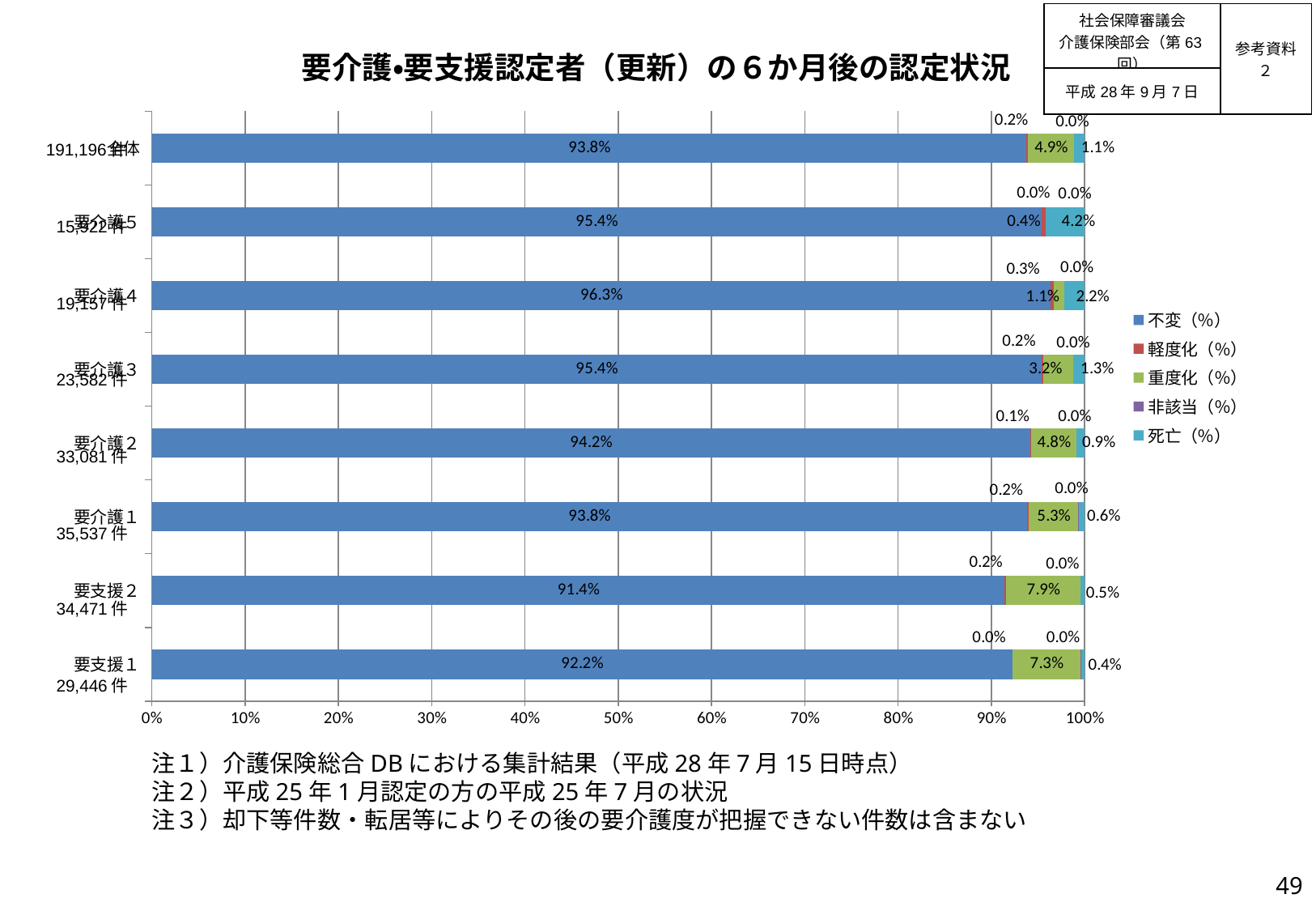
What kind of chart is shown on the slide? Stacked bar chart Which category has the highest 重度化（%） value? 要支援2 How many categories are shown on the chart? 8 Which category has the lowest 不変（%） value? 要支援2 How many series does the legend list? 5 Which category has the highest 不変（%） value? 要介護4 What is the difference between the 重度化（%） values for 要支援2 and 要支援1? 0.6% What is the 死亡（%） value for 要介護5? 4.2% What is the 軽度化（%） value for 要介護4? 0.3% What is the 重度化（%） value for 要介護1? 5.3% What is the 不変（%） value for 要支援2? 91.4% Which is larger, the 死亡（%） value for 要介護4 or for 要介護3? 要介護4